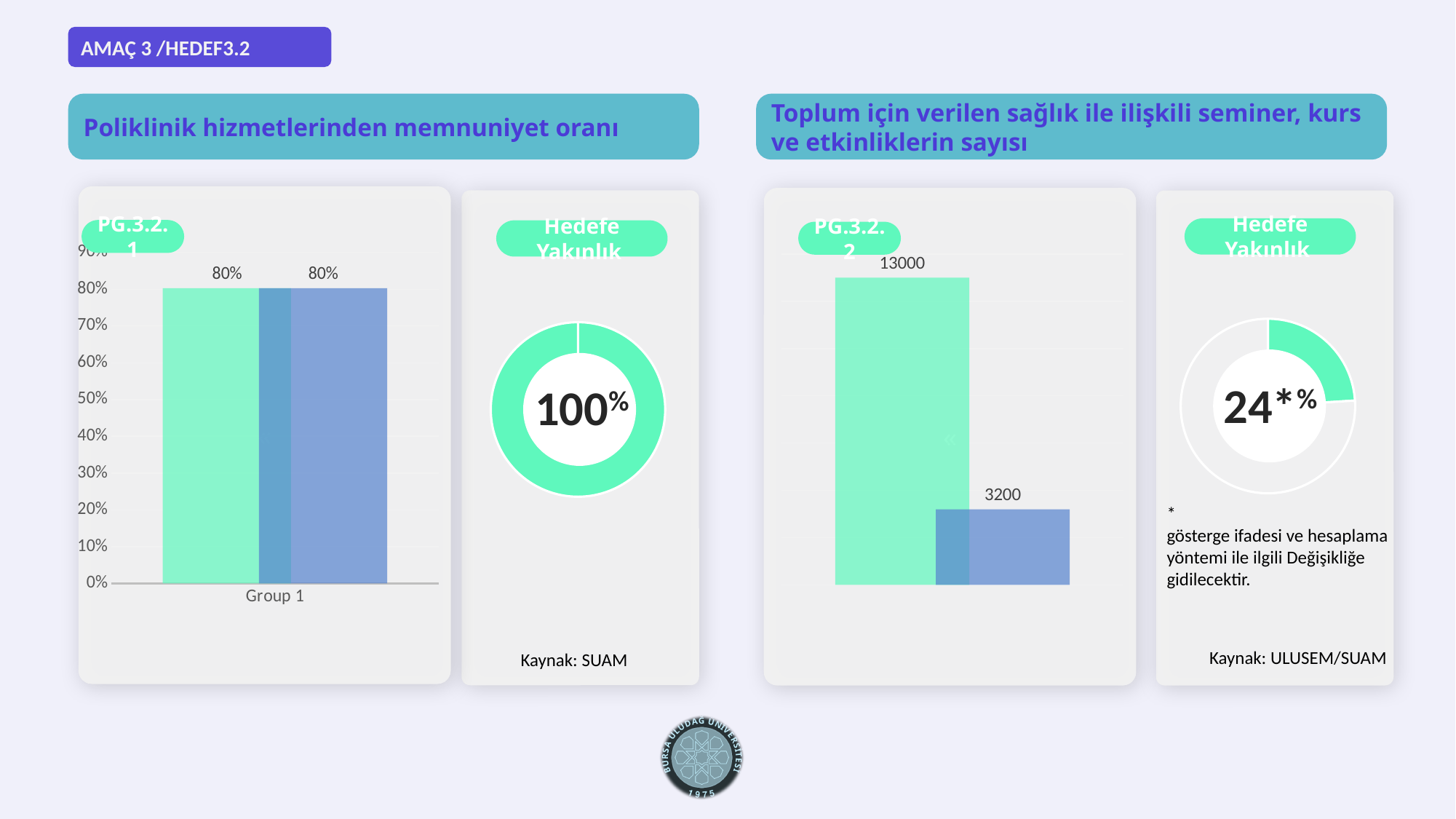
In the PG.3.2.1 bar chart on the left, what is the category label shown on the x axis? Group 1 In the PG.3.2.1 bar chart on the left, what value is labelled on the first (green) bar? 80% In the PG.3.2.2 bar chart on the right, what value is labelled on the green bar? 13000 In the PG.3.2.1 bar chart on the left, what value is labelled on the second (blue) bar? 80% How many bars are plotted in the PG.3.2.1 bar chart on the left? 2 What percentage is shown in the centre of the left 'Hedefe Yakınlık' donut chart? 100% In the PG.3.2.2 bar chart on the right, what value is labelled on the blue bar? 3200 In the PG.3.2.2 bar chart on the right, which bar is taller, the green bar or the blue bar? the green bar What value is shown in the centre of the right 'Hedefe Yakınlık' donut chart? 24*% In the PG.3.2.2 bar chart on the right, what is the difference between the green bar and the blue bar? 9800 What kind of chart is the PG.3.2.1 chart on the left? bar chart In the PG.3.2.1 bar chart on the left, what is the highest value shown on the y axis? 90%